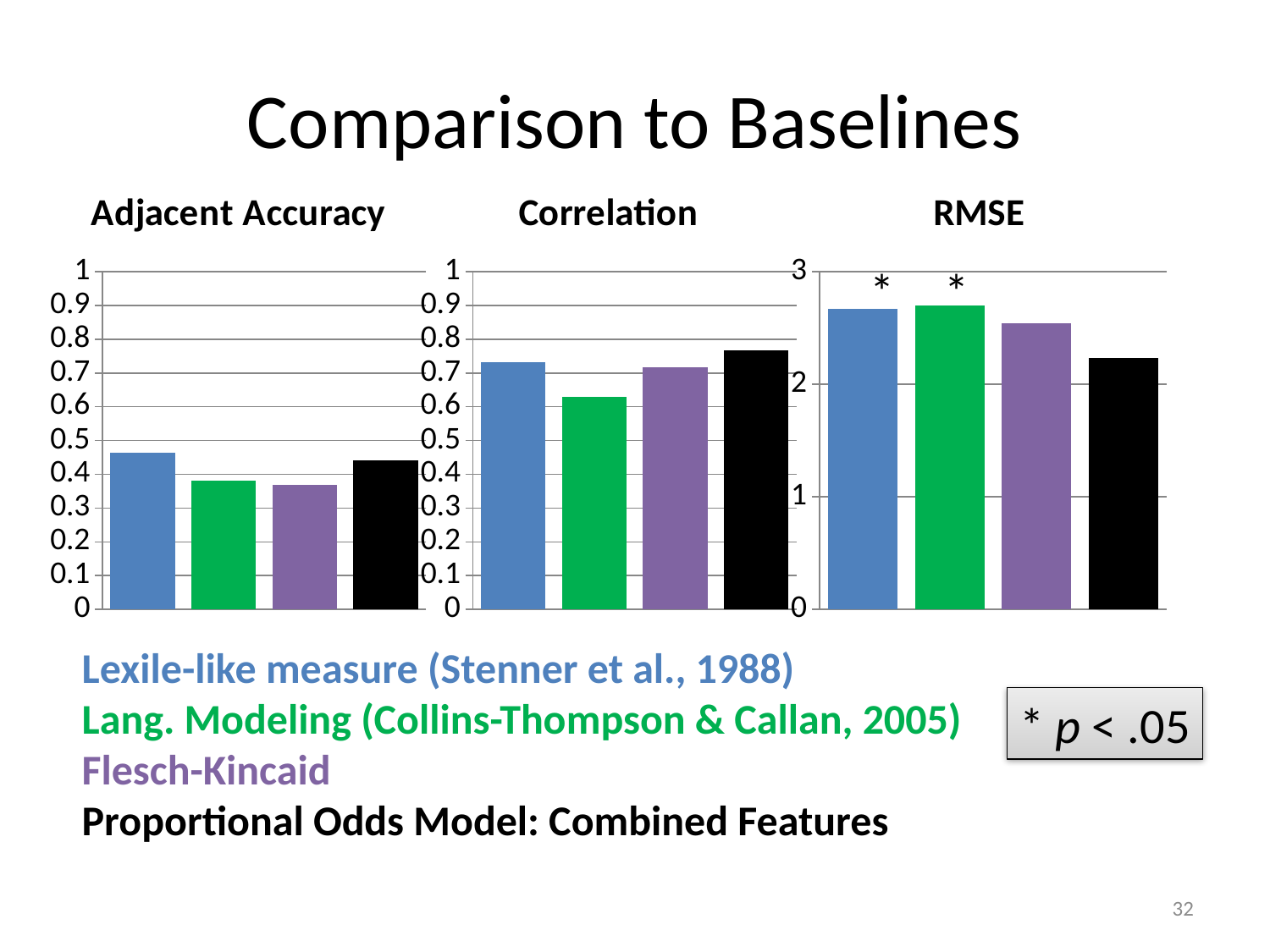
In the RMSE chart, which is larger: Flesch-Kincaid (purple) or the Proportional Odds Model (black)? Flesch-Kincaid What is the title of the slide containing the three charts? Comparison to Baselines In the Correlation chart, which method has the lowest value? Lang. Modeling In the Adjacent Accuracy chart, is the value for the Lexile-like measure (blue bar) greater or less than 0.4? greater In the RMSE chart, is the value for the Proportional Odds Model (black bar) greater or less than 2? greater In the Correlation chart, which method has the highest value? Proportional Odds Model: Combined Features In the RMSE chart, which method has the lowest value? Proportional Odds Model: Combined Features In the Adjacent Accuracy chart, is the value for Lang. Modeling (green bar) greater or less than 0.4? less How many bars are plotted in the Correlation chart? 4 What kind of chart is the Adjacent Accuracy chart? bar chart In the Adjacent Accuracy chart, which is larger: the Lexile-like measure (blue) or Lang. Modeling (green)? Lexile-like measure